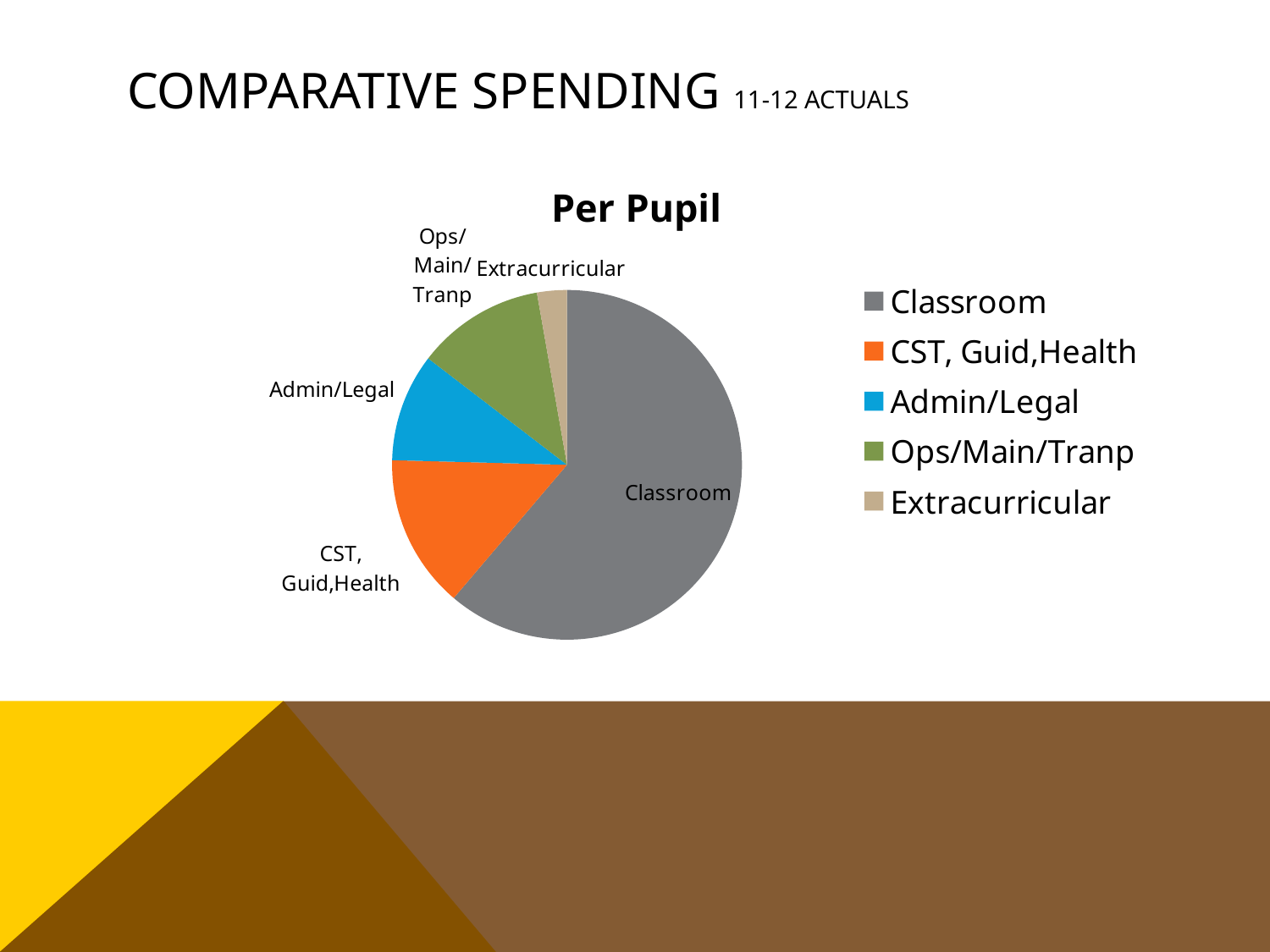
How many entries does the legend list? 5 Which category has the largest slice of the pie? Classroom Which slice is larger, CST, Guid,Health or Extracurricular? CST, Guid,Health Which slice is larger, Classroom or Admin/Legal? Classroom What kind of chart is shown on the slide? pie chart How many slices does the pie chart have? 5 Which category has the smallest slice of the pie? Extracurricular What colour is the Admin/Legal slice? blue Which slice is larger, Ops/Main/Tranp or Extracurricular? Ops/Main/Tranp What is the title of the chart? Per Pupil